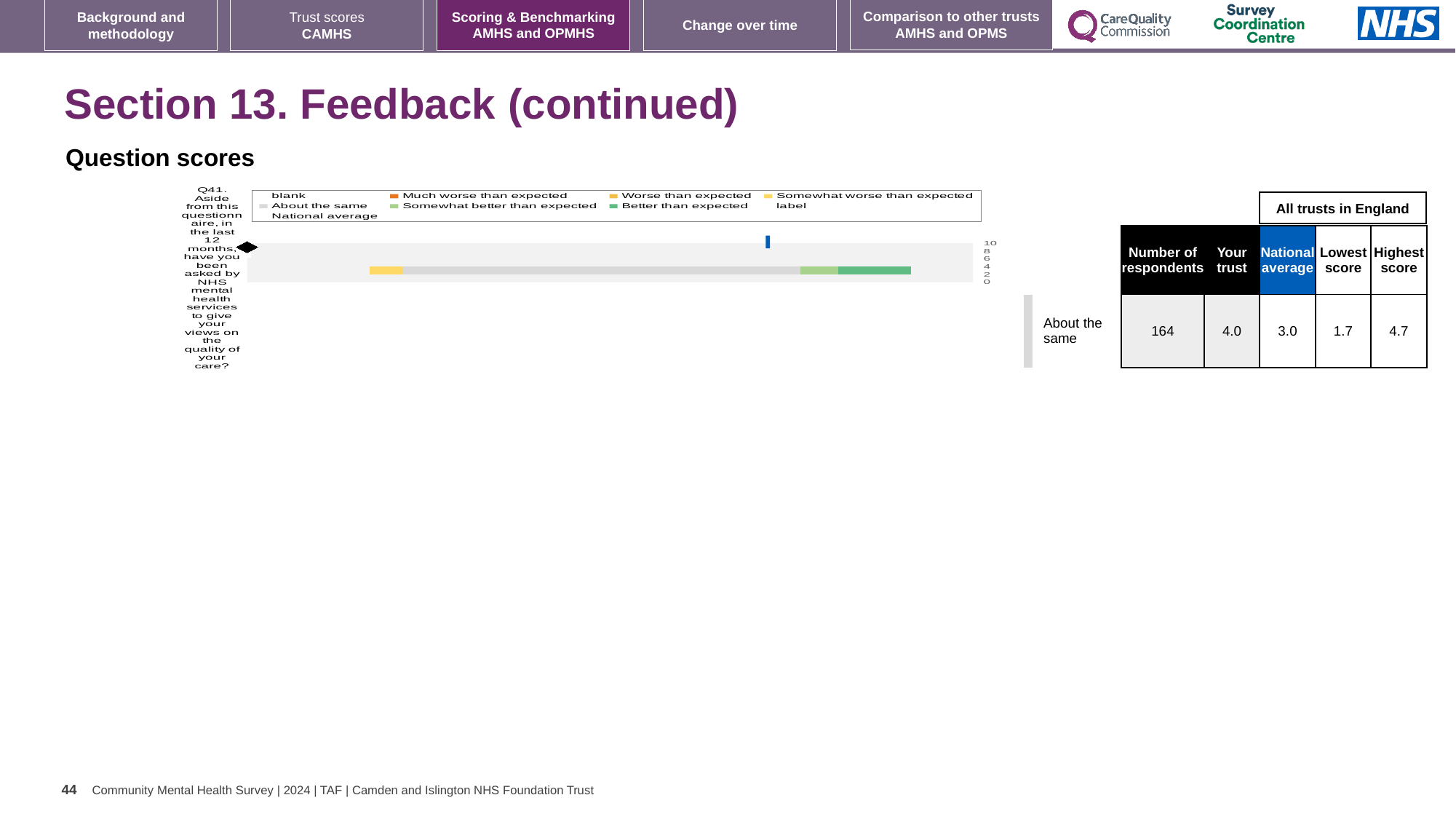
How many entries does the chart's legend list? 9 In the table beside the chart, what is the national average for Q41? 3.0 What is the difference between the highest score and the lowest score for Q41 in the table beside the chart? 3.0 In the table beside the chart, what is the number of respondents for Q41? 164 Which question number is plotted on the chart? Q41 In the table beside the chart, what is the 'Your trust' score for Q41? 4.0 Is the 'Your trust' score for Q41 larger or smaller than the national average? larger How many question categories are plotted on the chart? 1 What is the highest tick value shown on the chart's axis? 10 In the table beside the chart, what is the lowest score among all trusts in England for Q41? 1.7 What kind of chart is shown on the slide? bar chart In the table beside the chart, what is the highest score among all trusts in England for Q41? 4.7